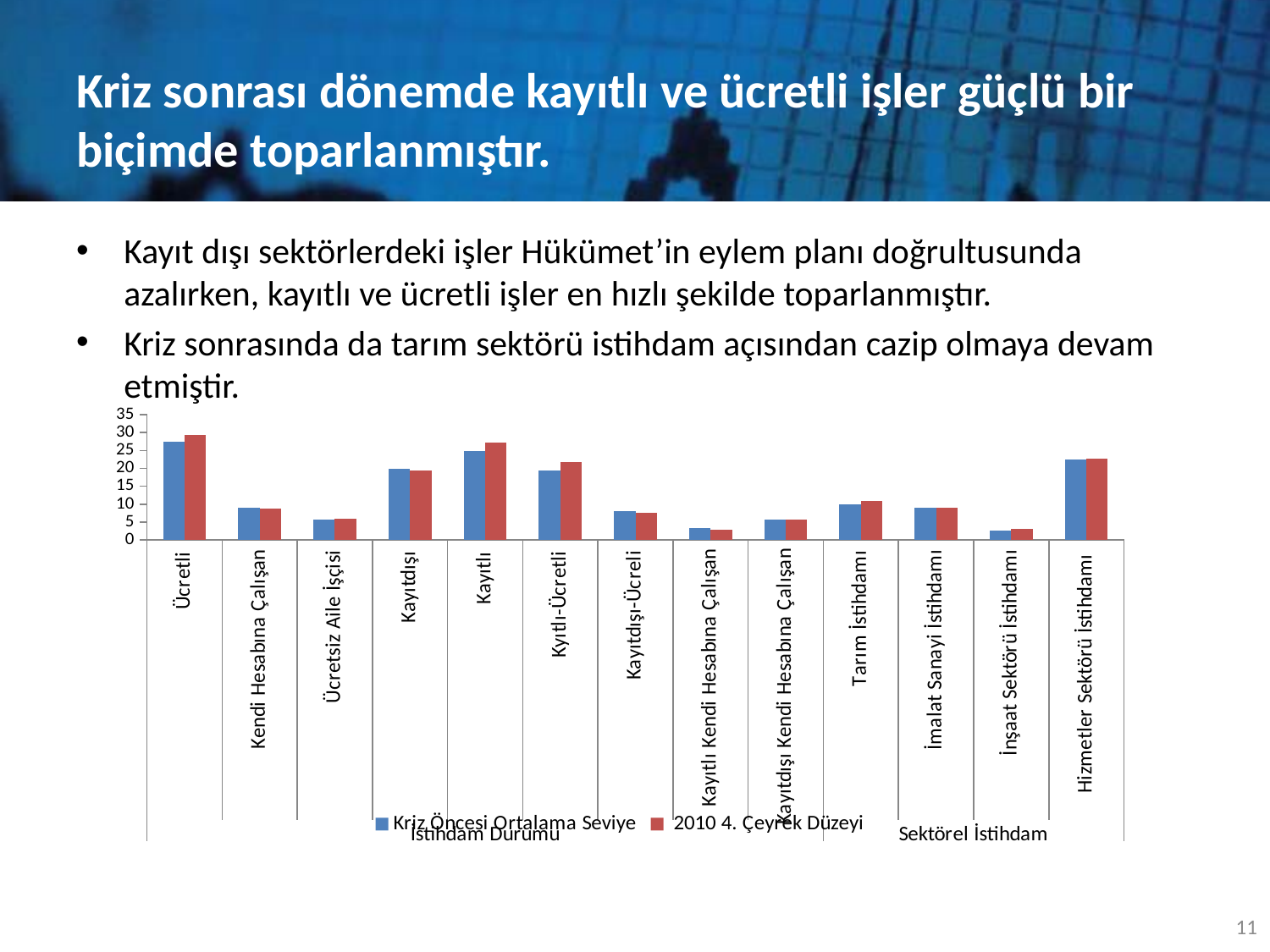
Is the Kriz Öncesi Ortalama Seviye value for Ücretli greater or less than 25? greater How many series does the chart legend list? 2 Which category has the highest value for the Kriz Öncesi Ortalama Seviye series? Ücretli For the 2010 4. Çeyrek Düzeyi series, which is larger: Kayıtlı or Kayıtdışı? Kayıtlı For Ücretli, which series has the larger value: Kriz Öncesi Ortalama Seviye or 2010 4. Çeyrek Düzeyi? 2010 4. Çeyrek Düzeyi Is the Kriz Öncesi Ortalama Seviye value for Hizmetler Sektörü İstihdamı greater or less than 20? greater How many categories are shown along the x axis of the chart? 13 What are the two group labels shown beneath the category axis of the chart? İstihdam Durumu and Sektörel İstihdam Which category has the highest value for the 2010 4. Çeyrek Düzeyi series? Ücretli What kind of chart is shown on the slide? bar chart Is the 2010 4. Çeyrek Düzeyi value for Kayıtlı greater or less than 25? greater